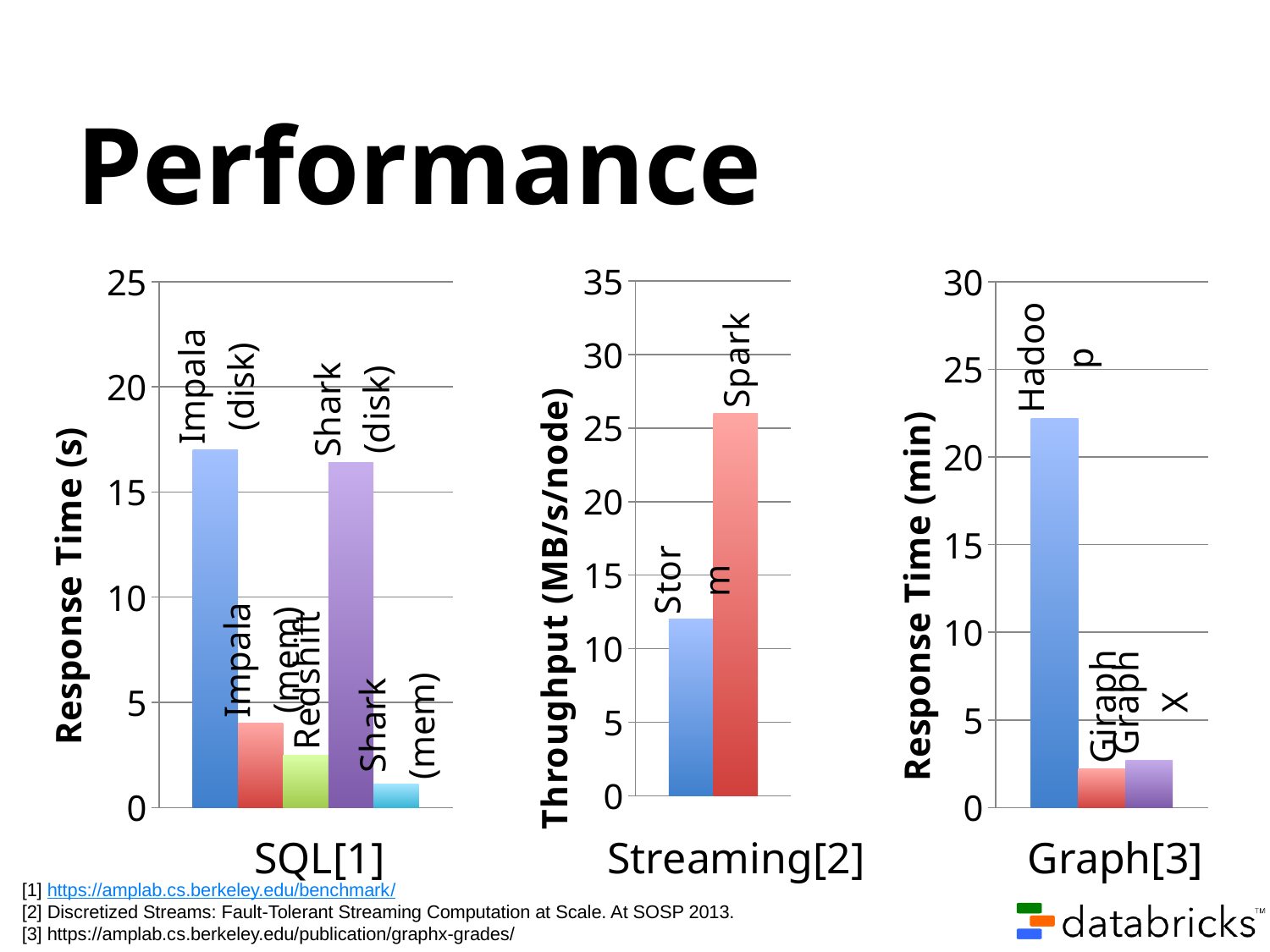
In the SQL[1] chart, is the response time for Impala (mem) greater or less than 5? less In the Graph[3] chart, is the response time for Hadoop greater or less than 20? greater In the SQL[1] chart, is the response time for Shark (disk) greater or less than 20? less What type of chart is the Graph[3] chart? bar chart In the Graph[3] chart, which system has the highest response time? Hadoop How many bars are plotted in the SQL[1] chart? 5 What is the y-axis label of the Streaming[2] chart? Throughput (MB/s/node) In the Streaming[2] chart, which system has the higher throughput, Storm or Spark? Spark In the SQL[1] chart, which has the lower response time, Redshift or Impala (disk)? Redshift